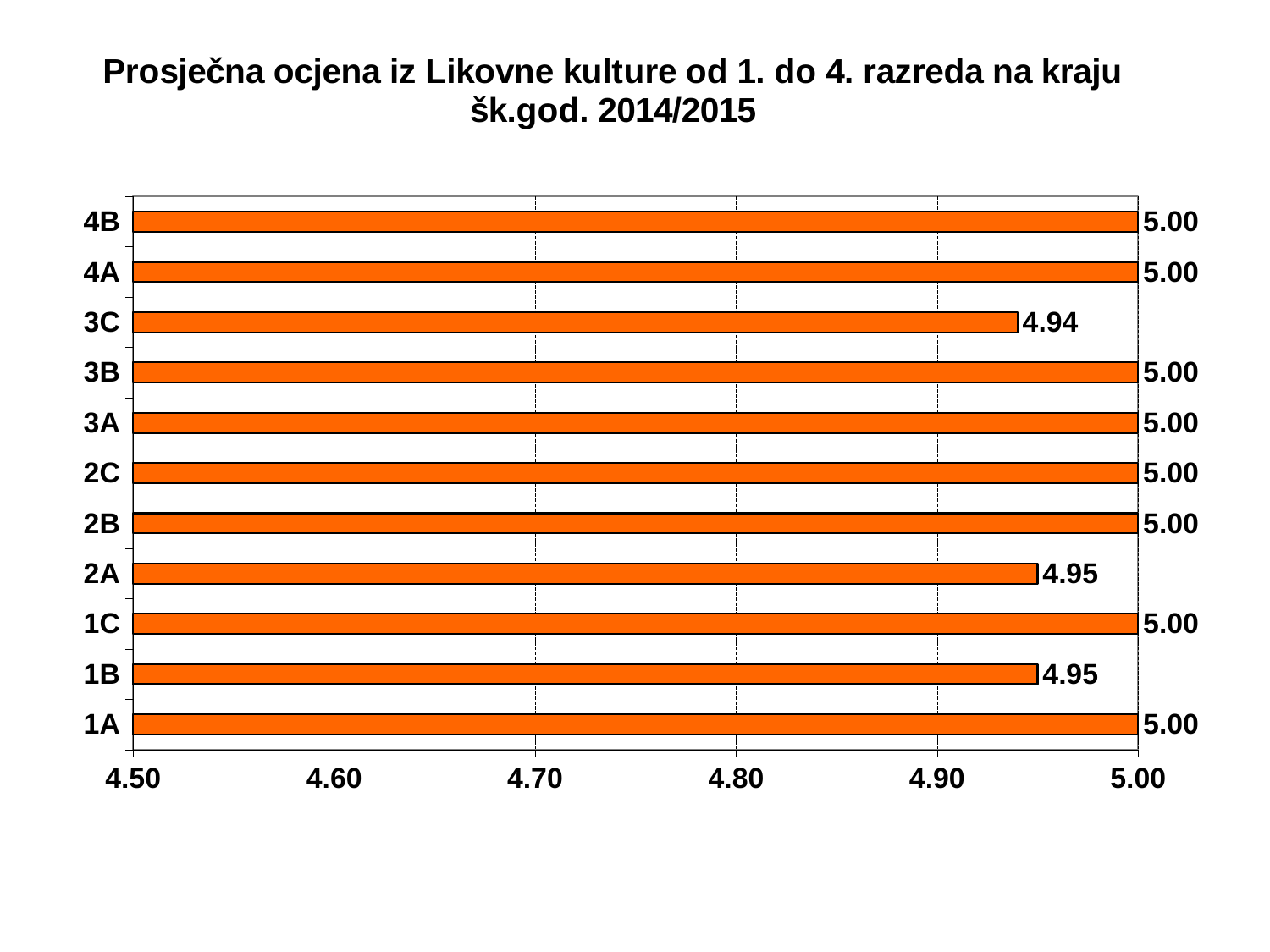
Which class has the lowest average grade? 3C What is the average grade for class 4B? 5.00 What is the difference between the average grade of 2B and 2A? 0.05 What kind of chart is shown on the slide? bar chart What is the average grade for class 2A? 4.95 What is the average grade for class 1B? 4.95 Which is larger, the average grade for 1C or for 1B? 1C How many classes are shown on the chart? 11 What is the average grade for class 3C? 4.94 Is the value for 3C greater or less than 4.90? greater What is the difference between the average grade of 1A and 3C? 0.06 What is the title of the chart? Prosječna ocjena iz Likovne kulture od 1. do 4. razreda na kraju šk.god. 2014/2015